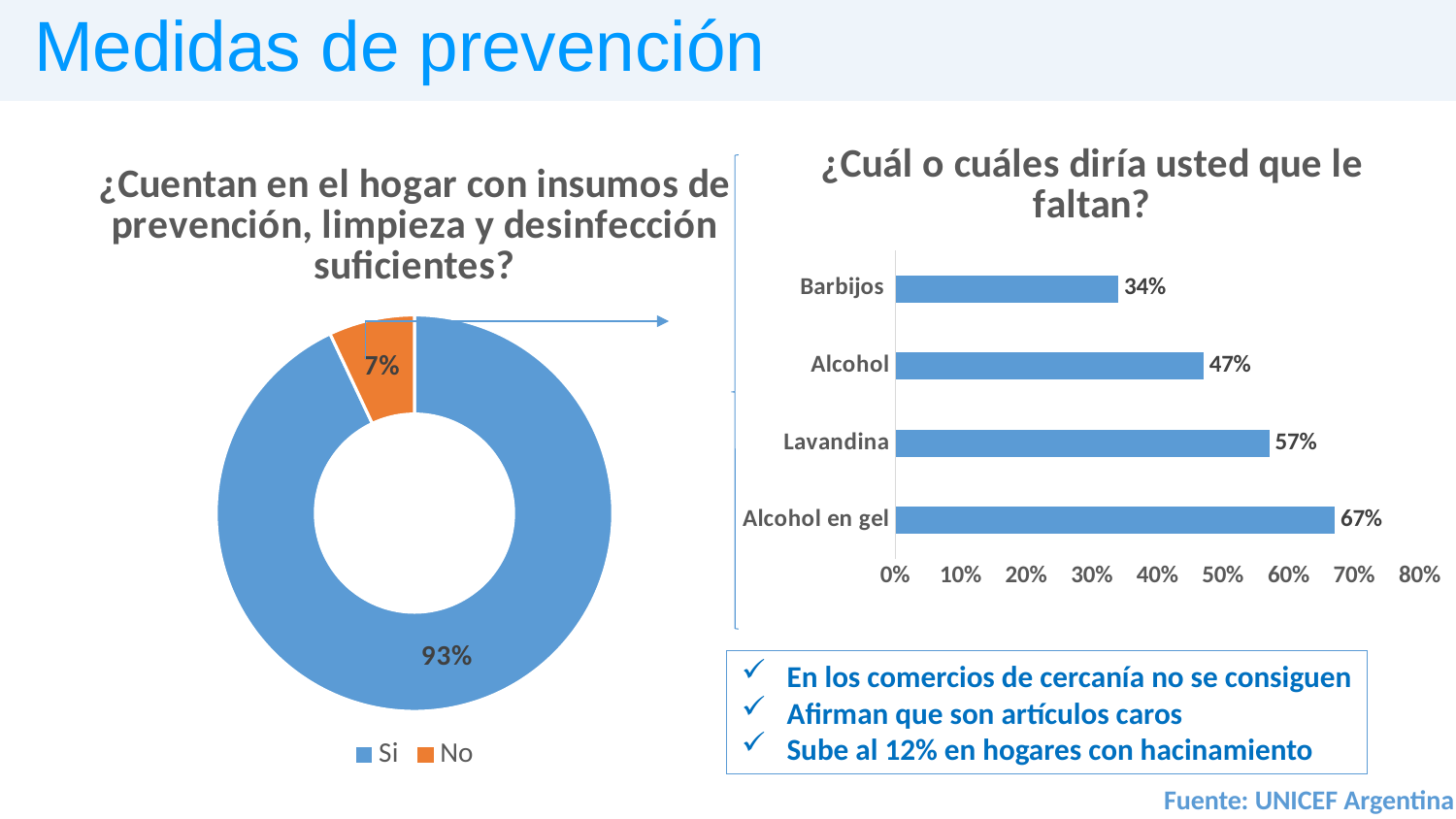
In the bar chart "¿Cuál o cuáles diría usted que le faltan?", how many categories are shown? 4 In the doughnut chart on the left, what colour is the "No" slice? Orange In the bar chart "¿Cuál o cuáles diría usted que le faltan?", which category has the highest value? Alcohol en gel In the bar chart "¿Cuál o cuáles diría usted que le faltan?", which is larger, Lavandina or Alcohol? Lavandina In the bar chart "¿Cuál o cuáles diría usted que le faltan?", what is the difference between Alcohol en gel and Alcohol? 20% In the bar chart "¿Cuál o cuáles diría usted que le faltan?", what is the value for Barbijos? 34% In the bar chart "¿Cuál o cuáles diría usted que le faltan?", which category has the lowest value? Barbijos In the doughnut chart on the left, what percentage answered "Si"? 93% What kind of chart is the one on the right of the slide? Bar chart In the doughnut chart on the left, what percentage answered "No"? 7% In the doughnut chart on the left, how many entries does the legend list? 2 In the bar chart "¿Cuál o cuáles diría usted que le faltan?", what is the value for Lavandina? 57%